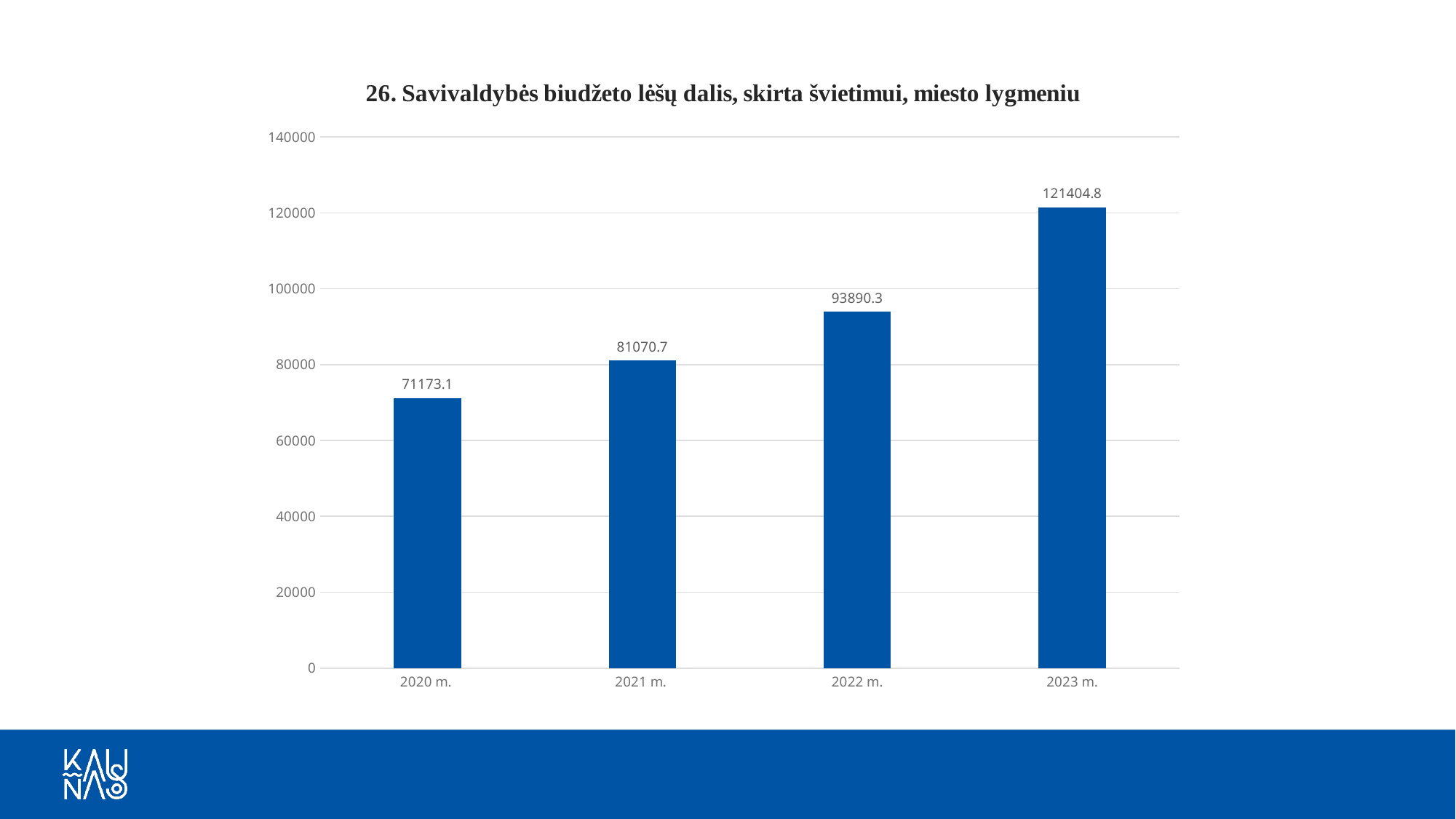
What is the value for 2020 m.? 71173.1 What is the value for 2021 m.? 81070.7 Do the values rise or fall from 2020 m. to 2023 m.? rise What is the difference between the values for 2023 m. and 2020 m.? 50231.7 What is the value for 2023 m.? 121404.8 Which year has the highest value? 2023 m. Which year has the lowest value? 2020 m. What is the difference between the values for 2022 m. and 2021 m.? 12819.6 How many years are shown on the chart? 4 What is the value for 2022 m.? 93890.3 Is the value for 2023 m. greater or less than 120000? greater Which is larger, the value for 2021 m. or the value for 2022 m.? 2022 m.